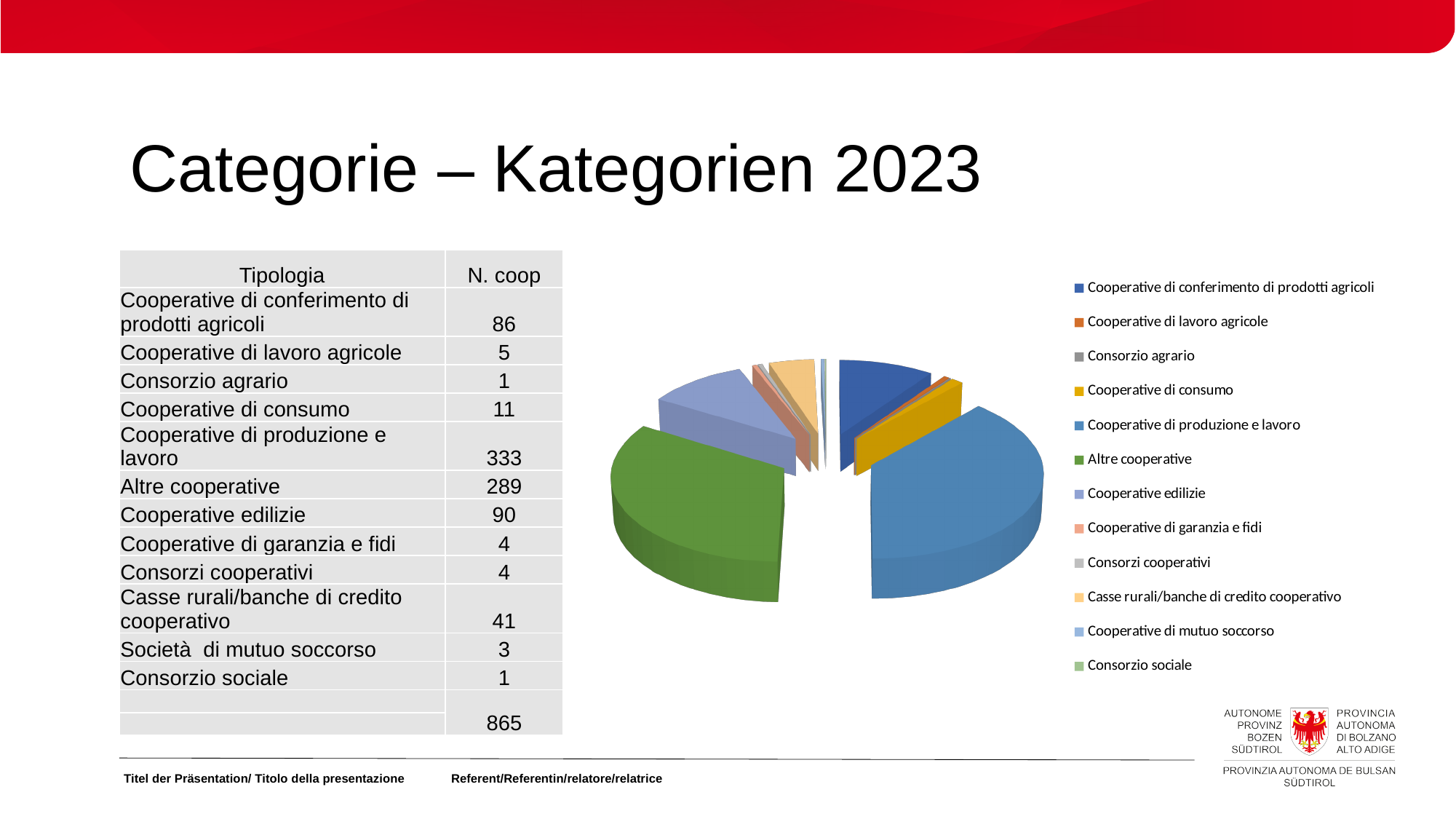
What kind of chart is shown on the slide? pie chart According to the table on the slide, how many cooperatives are in the category Cooperative edilizie? 90 Using the table values, what is the difference between Cooperative di produzione e lavoro and Altre cooperative? 44 Which slice is larger in the pie chart: Altre cooperative or Cooperative edilizie? Altre cooperative What is the total number of cooperatives shown at the bottom of the table? 865 Which slice is larger in the pie chart: Cooperative di produzione e lavoro or Cooperative di consumo? Cooperative di produzione e lavoro What is the first entry listed in the pie chart's legend? Cooperative di conferimento di prodotti agricoli According to the table on the slide, how many cooperatives are in the category Casse rurali/banche di credito cooperativo? 41 Which category has the largest slice in the pie chart? Cooperative di produzione e lavoro According to the table on the slide, how many cooperatives are in the category Cooperative di consumo? 11 What colour is the Altre cooperative slice in the pie chart? green How many categories does the pie chart's legend list? 12